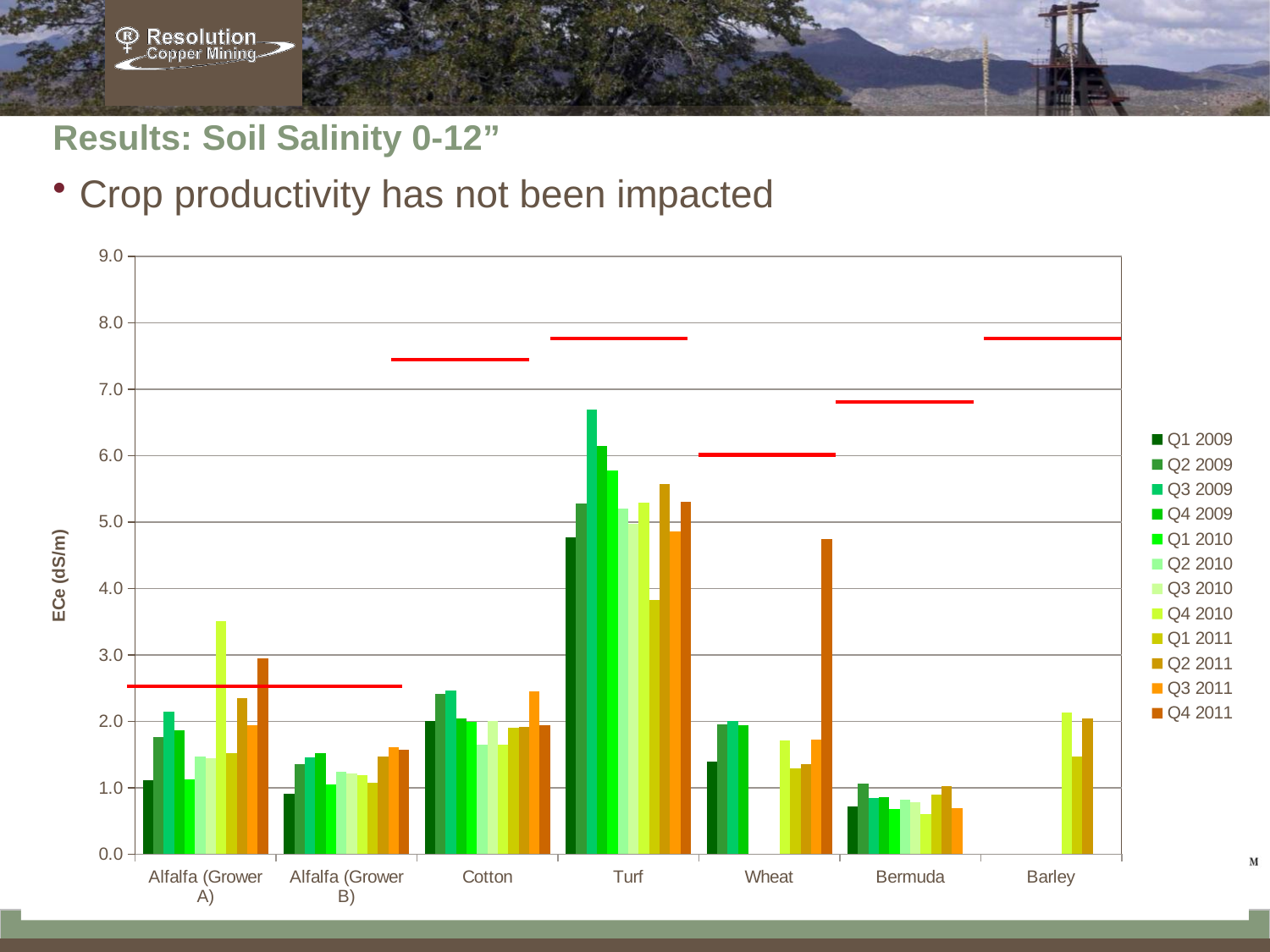
What kind of chart is shown on the slide? bar chart Which is larger: the Q4 2010 value for Alfalfa (Grower A) or the Q4 2010 value for Alfalfa (Grower B)? Alfalfa (Grower A) What is the label on the y axis of the chart? ECe (dS/m) How many crop categories are shown on the x axis of the chart? 7 Is the Q4 2010 value for Alfalfa (Grower A) greater or less than 3.0? greater Is the Q3 2011 value for Cotton greater or less than 2.0? greater Which is larger: the Q3 2009 value for Turf or the Q4 2011 value for Wheat? Q3 2009 value for Turf Is the Q1 2009 value for Bermuda greater or less than 1.0? less Which crop category has the highest bar in the chart? Turf How many series does the chart's legend list? 12